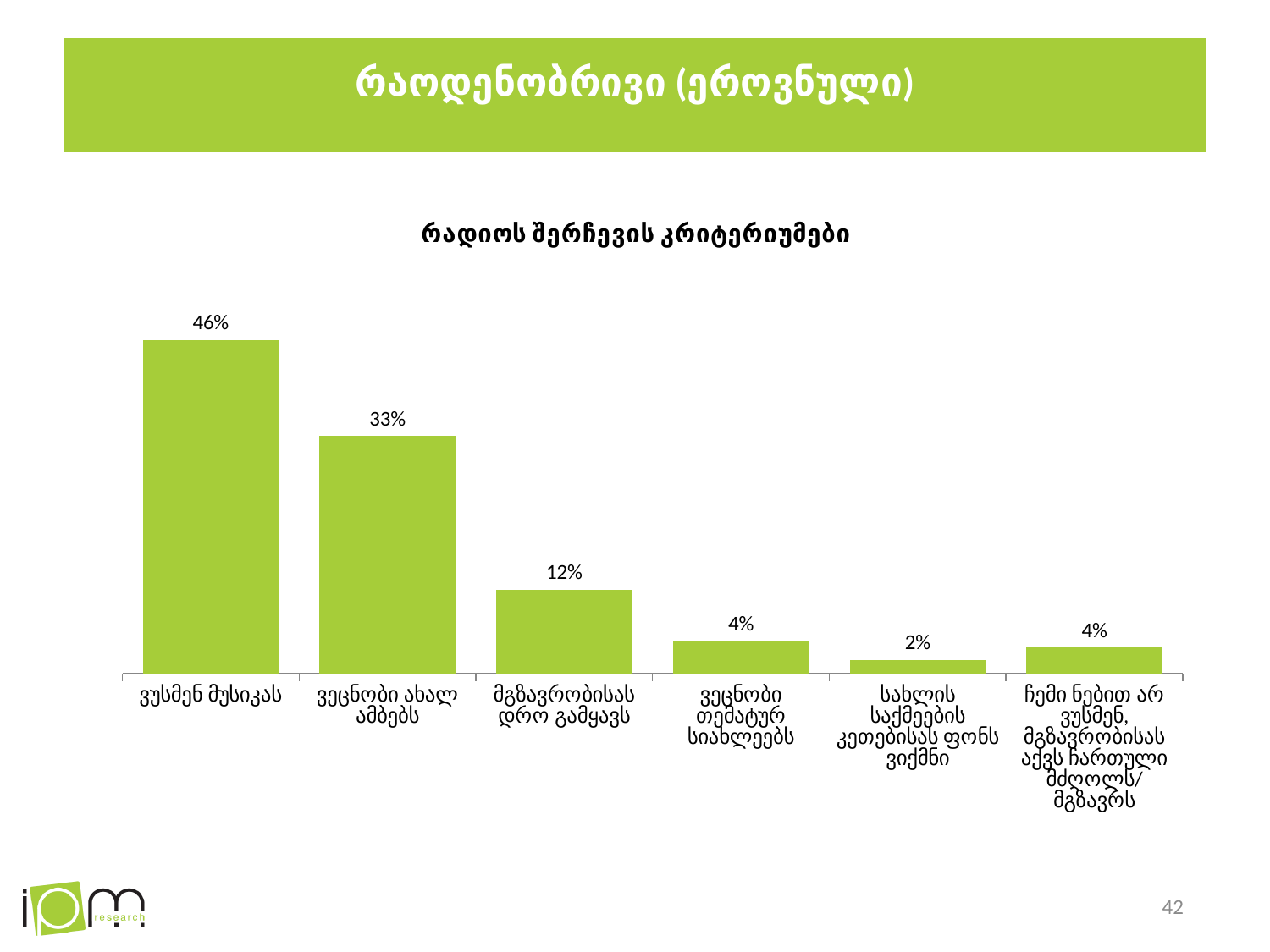
Do the values generally rise or fall from left to right across the categories? fall What is the title of the chart? რადიოს შერჩევის კრიტერიუმები Which is larger: the value for ვეცნობი ახალ ამბებს or the value for მგზავრობისას დრო გამყავს? ვეცნობი ახალ ამბებს What value is shown for სახლის საქმეების კეთებისას ფონს ვიქმნი? 2% Which category has the highest value? ვუსმენ მუსიკას What is the difference between the values for ვუსმენ მუსიკას and ვეცნობი ახალ ამბებს? 13% What value is shown for ვუსმენ მუსიკას? 46% What value is shown for ვეცნობი ახალ ამბებს? 33% What kind of chart is shown on the slide? bar chart How many categories are shown in the chart? 6 What value is shown for მგზავრობისას დრო გამყავს? 12% Which category has the lowest value? სახლის საქმეების კეთებისას ფონს ვიქმნი